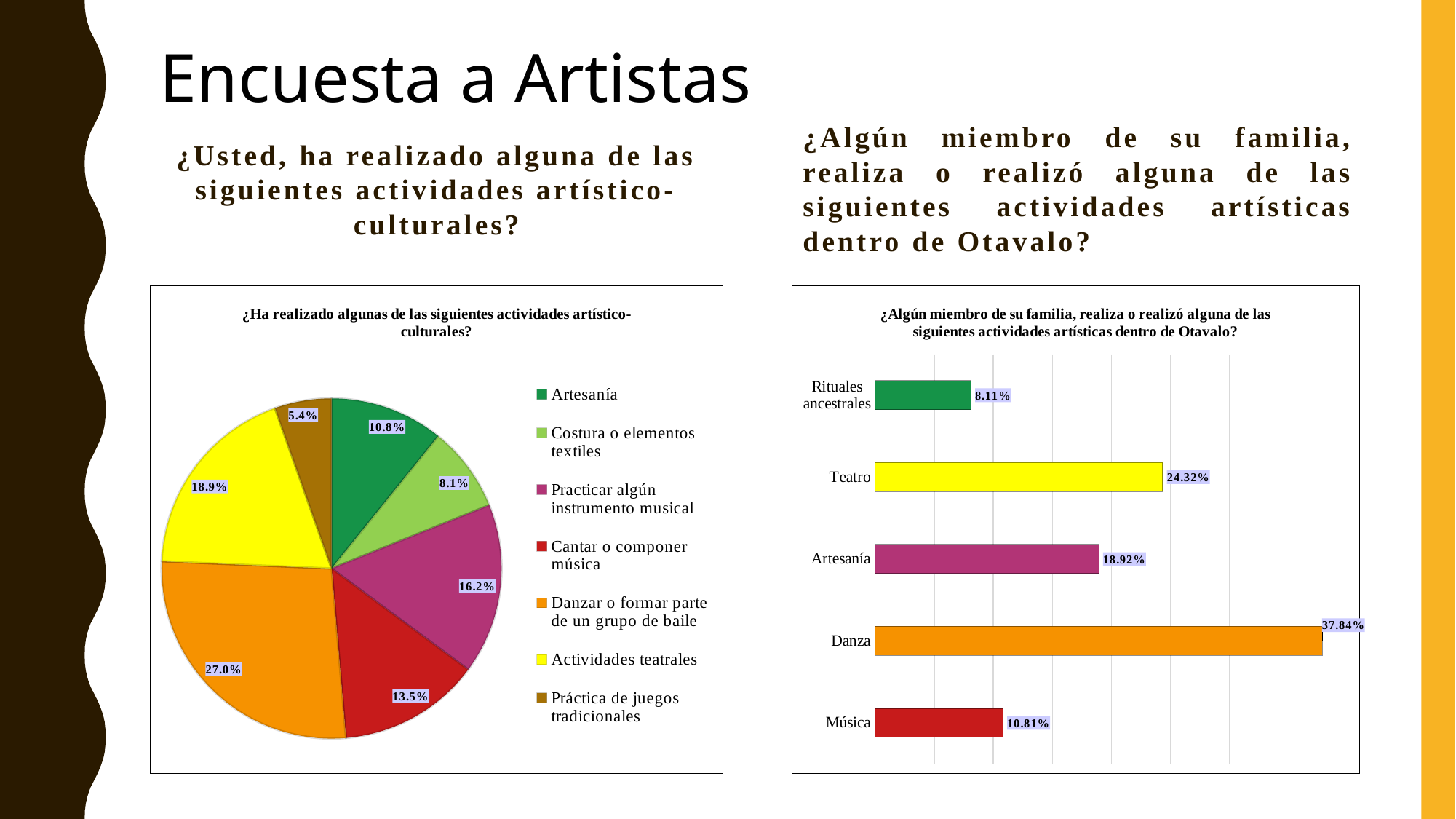
In the bar chart on the right, which is larger: Artesanía or Música? Artesanía In the pie chart on the left, what percentage is shown for Artesanía? 10.8% In the pie chart on the left, which category has the smallest slice? Práctica de juegos tradicionales What type of chart is shown on the right side of the slide? Bar chart In the bar chart on the right, which category has the highest value? Danza In the bar chart on the right, what is the value for Teatro? 24.32% In the pie chart on the left, what is the difference between the Actividades teatrales slice and the Costura o elementos textiles slice? 10.8% In the bar chart on the right, what is the difference between Danza and Teatro? 13.52% In the pie chart on the left, what colour is the Cantar o componer música slice? Red In the bar chart on the right, which category has the lowest value? Rituales ancestrales In the pie chart on the left, which category has the largest slice? Danzar o formar parte de un grupo de baile In the pie chart on the left, how many categories does the legend list? 7